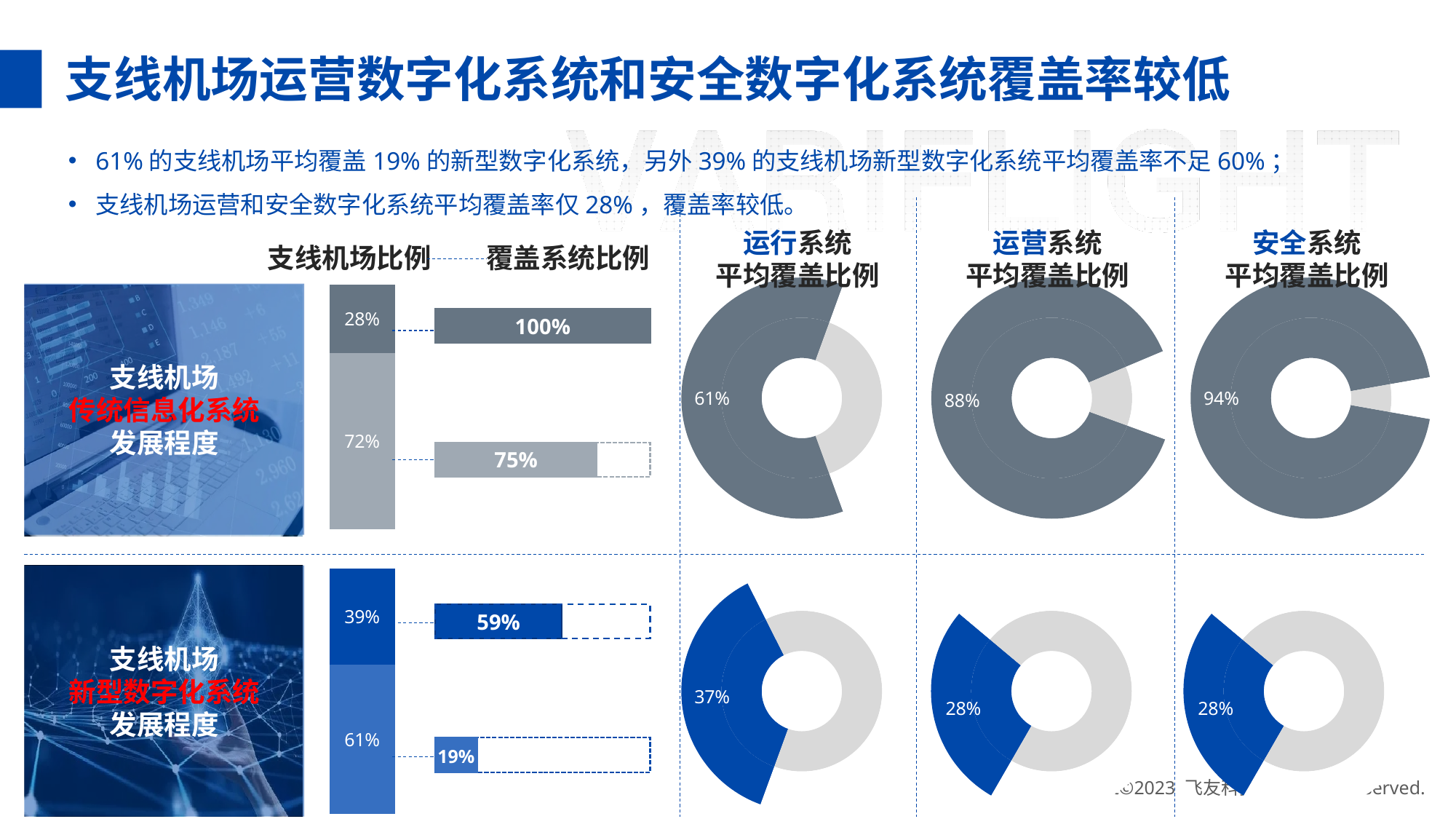
Among the three donut charts in the bottom row (新型数字化系统), which system has the highest average coverage ratio? 运行系统 In the 运行系统平均覆盖比例 donut chart for 支线机场传统信息化系统发展程度 (top row), what value is shown? 61% In the 运营系统平均覆盖比例 donut chart for 支线机场传统信息化系统发展程度 (top row), what value is shown? 88% In the 支线机场比例 stacked bar for 支线机场传统信息化系统发展程度 (top row), what is the value of the upper (dark) segment? 28% Among the three donut charts in the top row (传统信息化系统), which system has the highest average coverage ratio? 安全系统 In the 支线机场比例 stacked bar for 支线机场传统信息化系统发展程度 (top row), what is the value of the lower (light) segment? 72% In the 覆盖系统比例 bars for 支线机场新型数字化系统发展程度 (bottom row), what is the value of the lower bar? 19% Which is larger: the 运行系统平均覆盖比例 for 传统信息化系统 (top row) or for 新型数字化系统 (bottom row)? 传统信息化系统 (61%) In the 安全系统平均覆盖比例 donut chart for 支线机场新型数字化系统发展程度 (bottom row), what value is shown? 28% In the 覆盖系统比例 bars for 支线机场传统信息化系统发展程度 (top row), what is the value of the upper bar? 100% In the 覆盖系统比例 bars for 支线机场传统信息化系统发展程度 (top row), what is the difference between the upper bar (100%) and the lower bar (75%)? 25% In the 支线机场比例 stacked bar for 支线机场新型数字化系统发展程度 (bottom row), what is the value of the upper segment? 39%